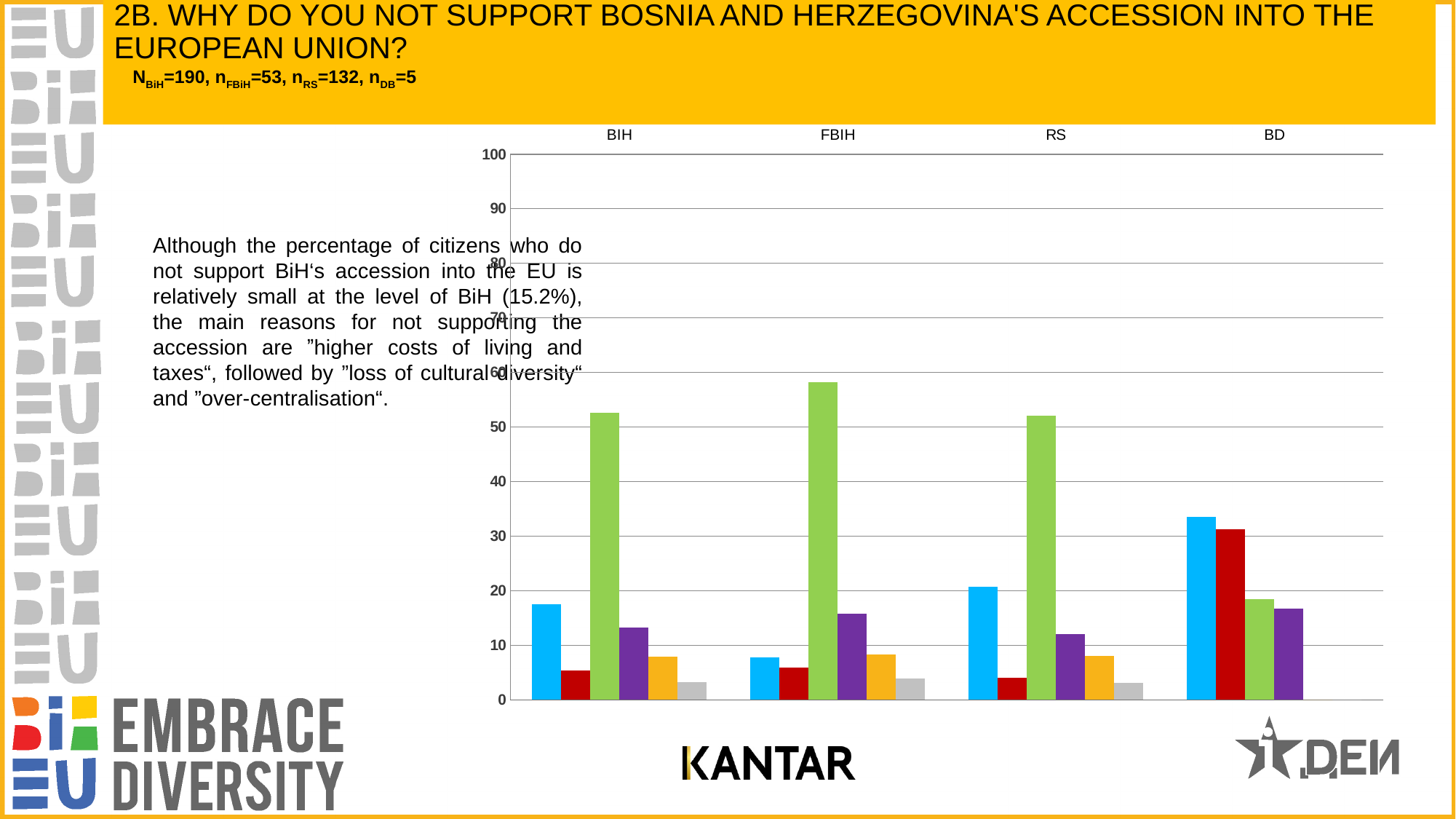
Which category has the tallest light blue bar? BD Is the light blue bar for RS greater or less than 30? less How many categories are shown along the x axis of the chart? 4 In the BIH group, which coloured bar is the tallest? green Is the light blue bar for BD greater or less than 30? greater In the BIH group, which coloured bar is the shortest? grey How many bars are shown for the BD category? 4 What kind of chart is shown on the slide? bar chart Is the green bar for FBIH taller or shorter than the green bar for BIH? taller Which category has the tallest red bar? BD Is the green bar for FBIH greater or less than 50? greater